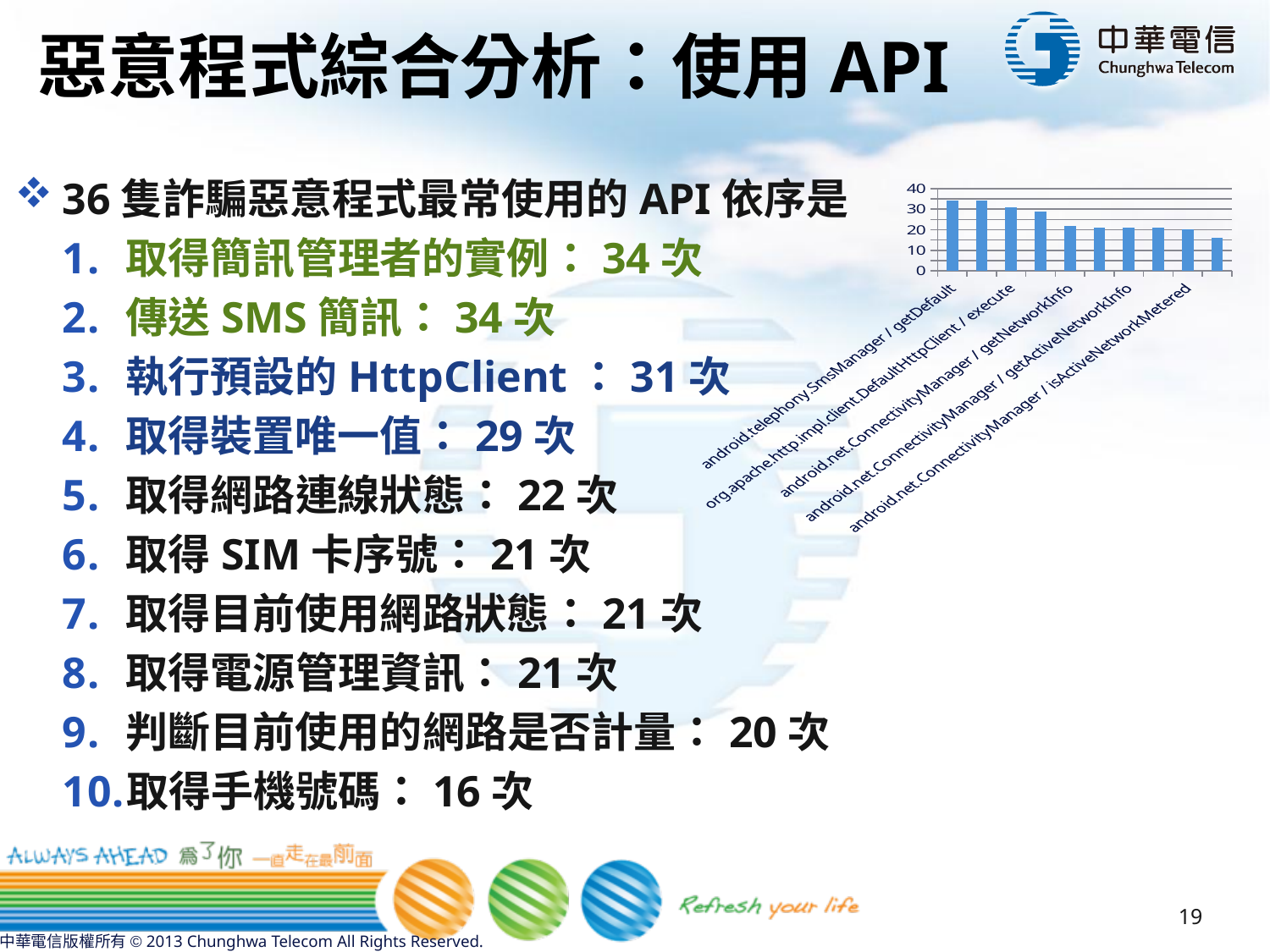
Which has the larger value: android.telephony.SmsManager / getDefault or android.net.ConnectivityManager / getNetworkInfo? android.telephony.SmsManager / getDefault How many bars does the chart contain? 10 Is the value for android.net.ConnectivityManager / isActiveNetworkMetered greater or less than 30? less Is the value for android.net.ConnectivityManager / getNetworkInfo greater or less than 30? less What kind of chart is shown on the slide? bar chart Is the value for android.net.ConnectivityManager / getActiveNetworkInfo greater or less than 30? less Do the bar values generally rise or fall from left to right across the chart? fall What colour are the bars in the chart? blue Which has the larger value: org.apache.http.impl.client.DefaultHttpClient / execute or android.net.ConnectivityManager / isActiveNetworkMetered? org.apache.http.impl.client.DefaultHttpClient / execute What is the highest tick value shown on the chart's vertical axis? 40